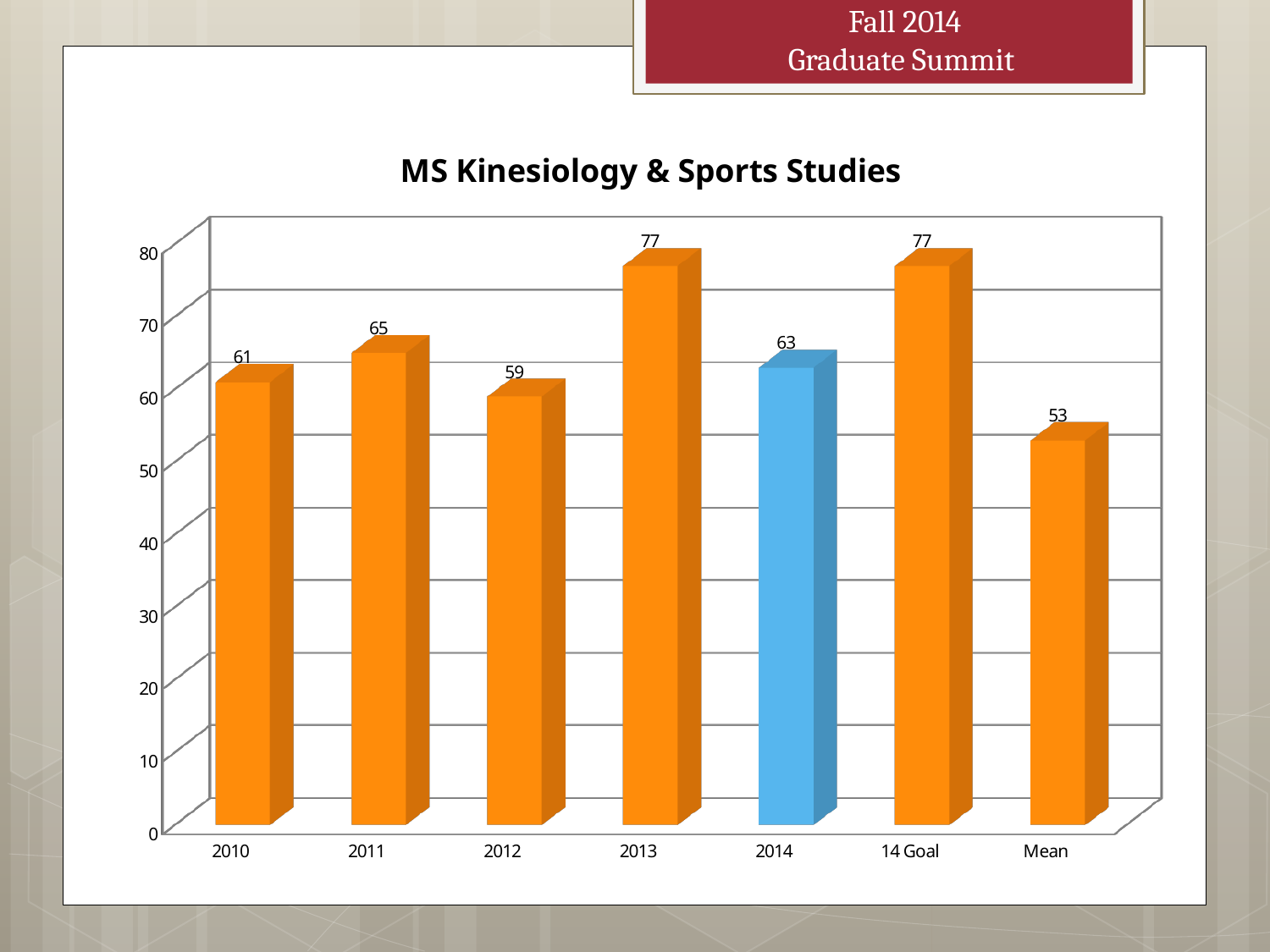
What is the value for Mean? 53 What is the value for 14 Goal? 77 What is the difference between the values for 2013 and 2012? 18 Is the value for 2012 greater or less than 50? greater What is the difference between the 14 Goal value and the 2014 value? 14 Which bar is shown in a different colour (blue) from the others? 2014 Which category has the lowest value? Mean What kind of chart is shown on the slide? Bar chart What is the value for 2010? 61 Which is larger, the value for 2011 or the value for 2014? 2011 How many bars are shown in the chart? 7 What is the value for 2014? 63